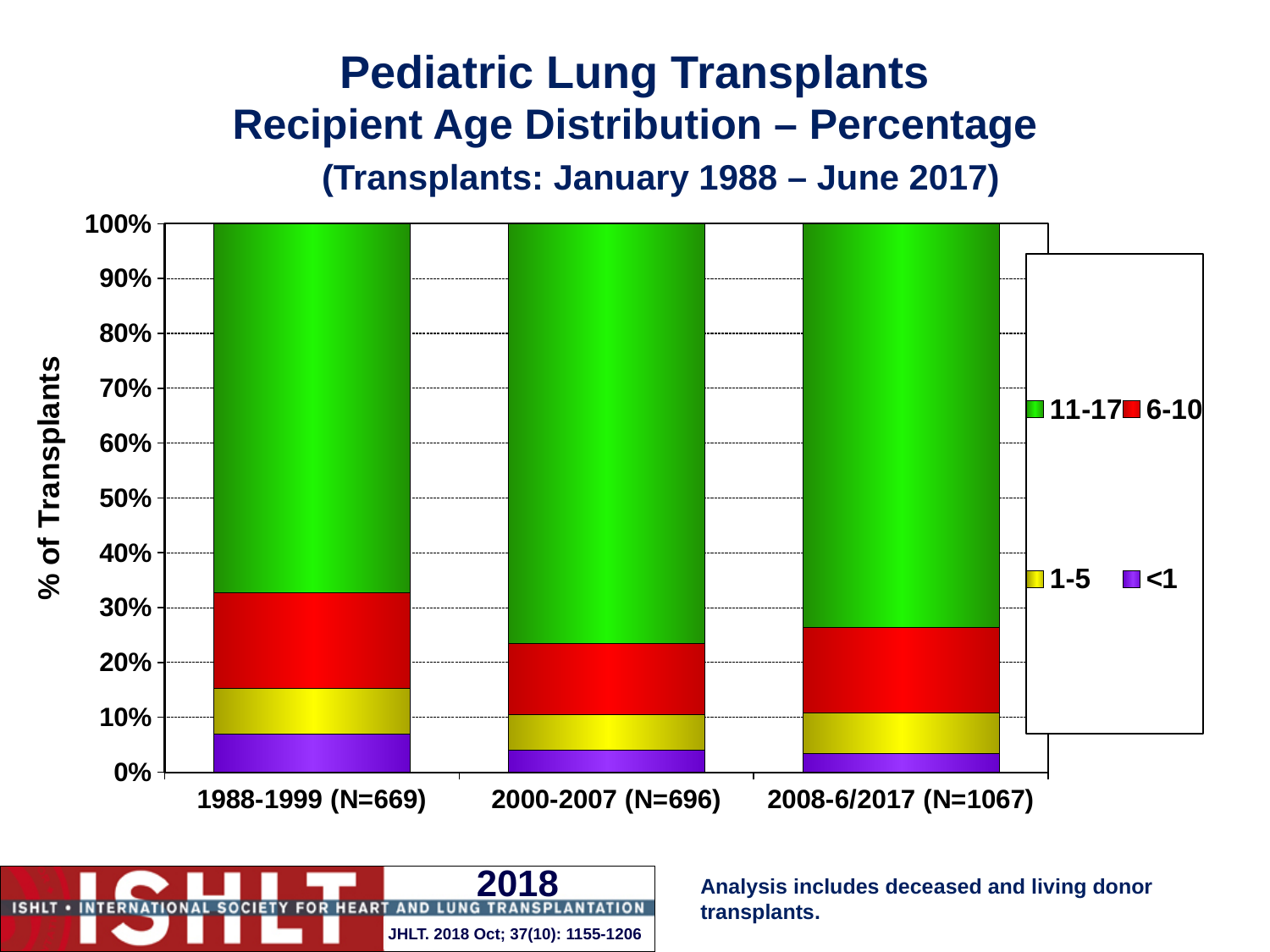
Which time period has the largest share of recipients aged <1? 1988-1999 (N=669) Which time period has the largest share of recipients aged 11-17? 2000-2007 (N=696) Is the share of recipients aged 11-17 in 2000-2007 greater or less than 70%? greater How many age groups does the legend list? 4 What kind of chart is shown on the slide? Stacked bar chart How many time periods (bars) are shown on the x axis? 3 Which time period has the smallest share of recipients aged 11-17? 1988-1999 (N=669) Is the share of recipients aged 11-17 in 1988-1999 greater or less than 70%? less Does the share of recipients aged <1 rise or fall across the three periods from left to right? Fall Which period has the larger share of recipients aged 6-10: 1988-1999 or 2000-2007? 1988-1999 What is the number of transplants (N) for the 2008-6/2017 period? 1067 Is the share of recipients aged <1 in 1988-1999 greater or less than 10%? less